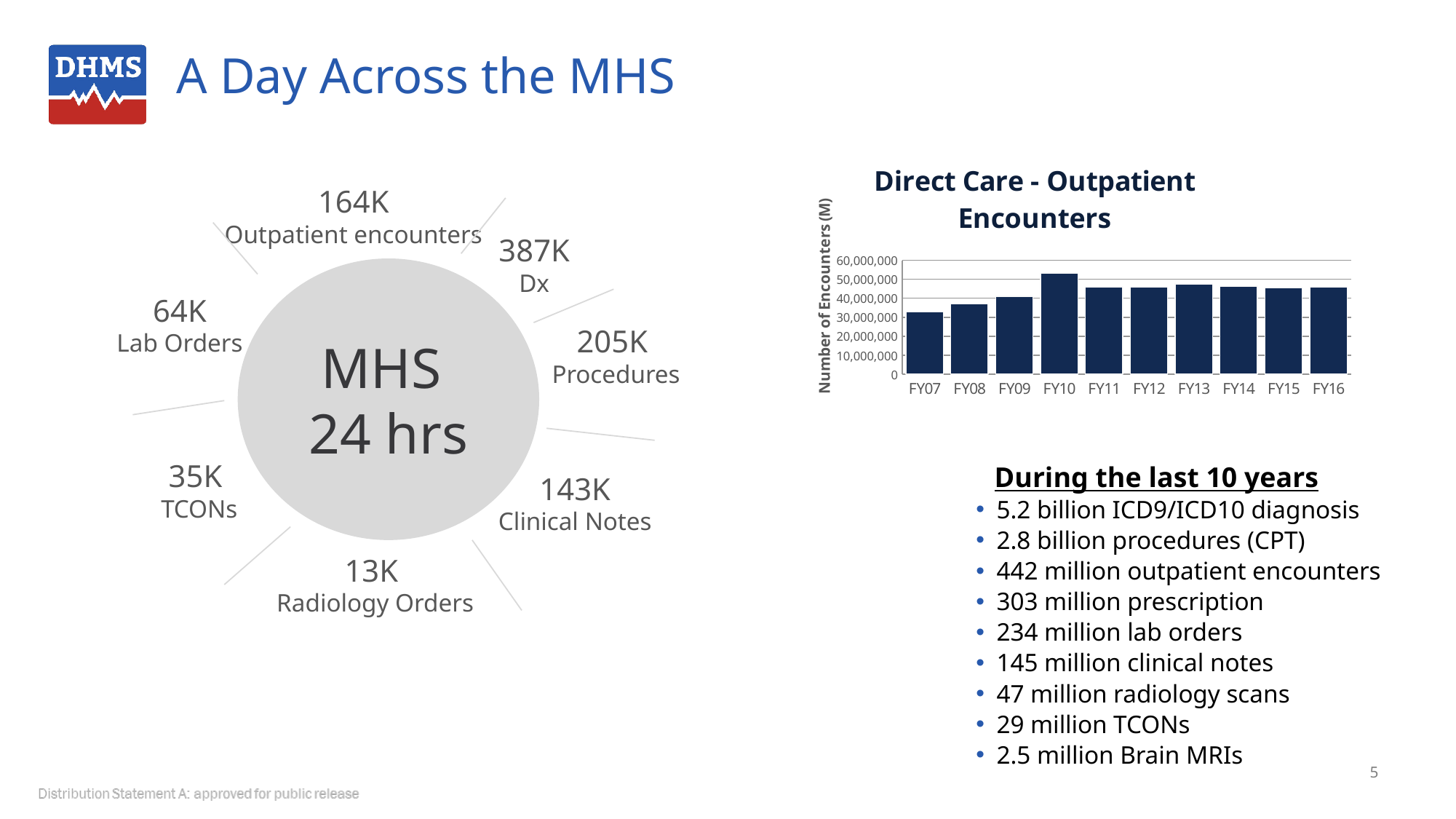
In the "Direct Care - Outpatient Encounters" chart, which is larger, the value for FY07 or the value for FY10? FY10 In the "Direct Care - Outpatient Encounters" chart, do the values rise or fall from FY07 to FY10? rise In the "Direct Care - Outpatient Encounters" chart, which fiscal year has the highest number of encounters? FY10 What kind of chart is the "Direct Care - Outpatient Encounters" chart? bar chart What is the first fiscal year shown on the x axis of the "Direct Care - Outpatient Encounters" chart? FY07 In the "Direct Care - Outpatient Encounters" chart, is the value for FY10 greater or less than 50,000,000? greater What is the y-axis label of the "Direct Care - Outpatient Encounters" chart? Number of Encounters (M) In the "Direct Care - Outpatient Encounters" chart, is the value for FY13 greater or less than 40,000,000? greater In the "Direct Care - Outpatient Encounters" chart, is the value for FY07 greater or less than 40,000,000? less In the "Direct Care - Outpatient Encounters" chart, which is larger, the value for FY08 or the value for FY09? FY09 How many fiscal years are shown on the x axis of the "Direct Care - Outpatient Encounters" chart? 10 In the "Direct Care - Outpatient Encounters" chart, which fiscal year has the lowest number of encounters? FY07